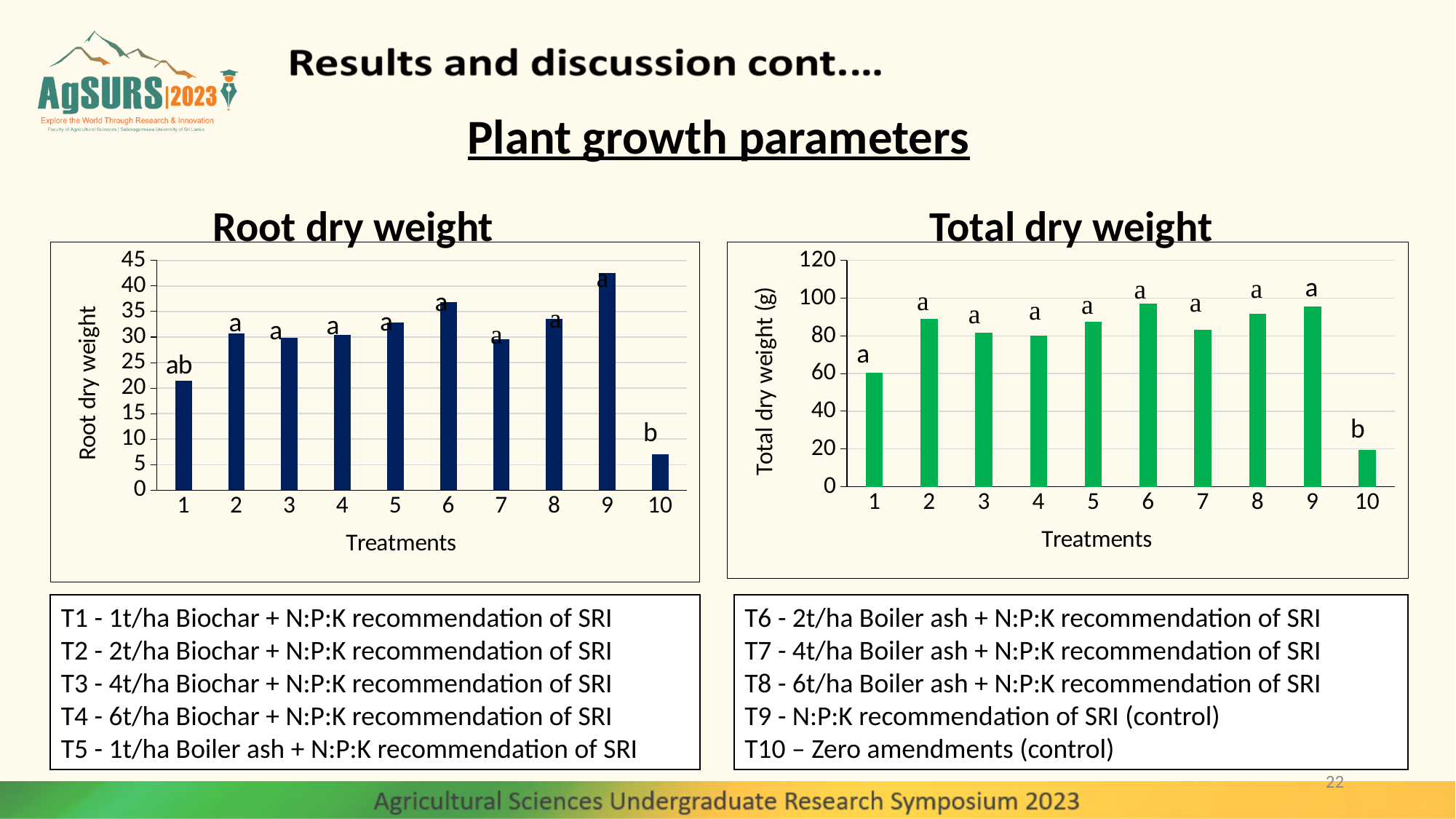
What kind of chart is the Root dry weight chart? bar chart In the Root dry weight chart, is the value for treatment 9 greater or less than 40? greater In the Total dry weight chart, which treatment has the lowest total dry weight? 10 In the Total dry weight chart, which has the larger value, treatment 1 or treatment 2? treatment 2 In the Total dry weight chart, is the value for treatment 1 greater or less than 40? greater In the Total dry weight chart, is the value for treatment 10 greater or less than 40? less What is the y-axis title of the Total dry weight chart? Total dry weight (g) In the Root dry weight chart, which treatment has the highest root dry weight? 9 How many treatments are plotted in the Total dry weight chart? 10 In the Root dry weight chart, which treatment has the lowest root dry weight? 10 In the Root dry weight chart, which has the larger value, treatment 6 or treatment 1? treatment 6